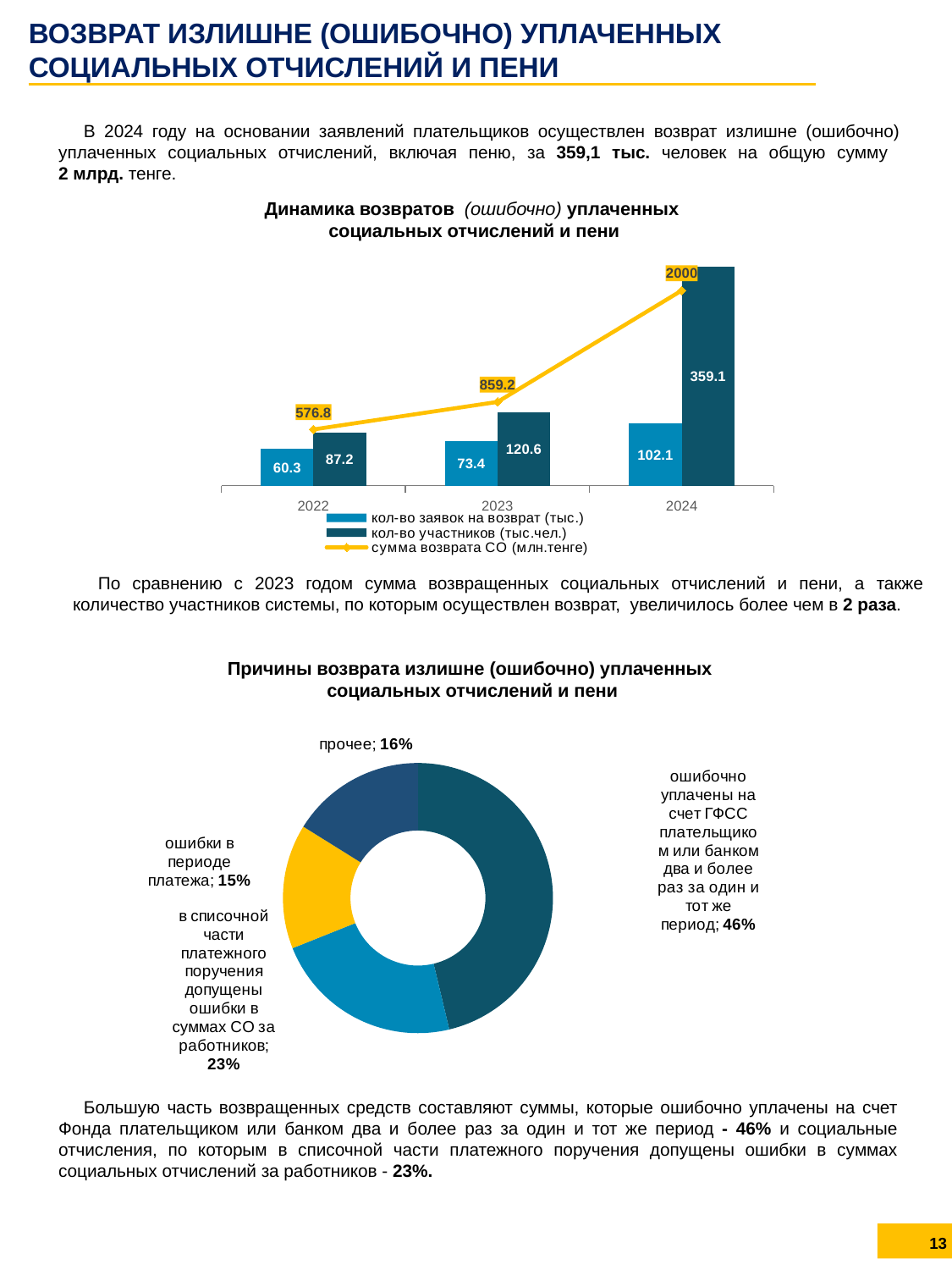
In the chart 'Динамика возвратов (ошибочно) уплаченных социальных отчислений и пени', in which year is 'сумма возврата СО (млн.тенге)' highest? 2024 In the chart 'Динамика возвратов (ошибочно) уплаченных социальных отчислений и пени', does 'сумма возврата СО (млн.тенге)' rise or fall from 2022 to 2024? rise In the chart 'Динамика возвратов (ошибочно) уплаченных социальных отчислений и пени', how many years are shown on the x axis? 3 In the chart 'Динамика возвратов (ошибочно) уплаченных социальных отчислений и пени', what is the value of 'сумма возврата СО (млн.тенге)' for 2022? 576.8 In the chart 'Причины возврата излишне (ошибочно) уплаченных социальных отчислений и пени', which category has the largest share? ошибочно уплачены на счет ГФСС плательщиком или банком два и более раз за один и тот же период What type of chart is 'Причины возврата излишне (ошибочно) уплаченных социальных отчислений и пени'? doughnut chart In the chart 'Динамика возвратов (ошибочно) уплаченных социальных отчислений и пени', what is the difference between 'кол-во участников (тыс.чел.)' in 2024 and 2023? 238.5 In the chart 'Причины возврата излишне (ошибочно) уплаченных социальных отчислений и пени', what share does 'ошибки в периоде платежа' have? 15% In the chart 'Динамика возвратов (ошибочно) уплаченных социальных отчислений и пени', what is the value of 'кол-во участников (тыс.чел.)' for 2024? 359.1 In the chart 'Динамика возвратов (ошибочно) уплаченных социальных отчислений и пени', which is larger in 2022: 'кол-во заявок на возврат (тыс.)' or 'кол-во участников (тыс.чел.)'? кол-во участников (тыс.чел.) In the chart 'Динамика возвратов (ошибочно) уплаченных социальных отчислений и пени', how many series does the legend list? 3 In the chart 'Динамика возвратов (ошибочно) уплаченных социальных отчислений и пени', what is the value of 'кол-во заявок на возврат (тыс.)' for 2023? 73.4